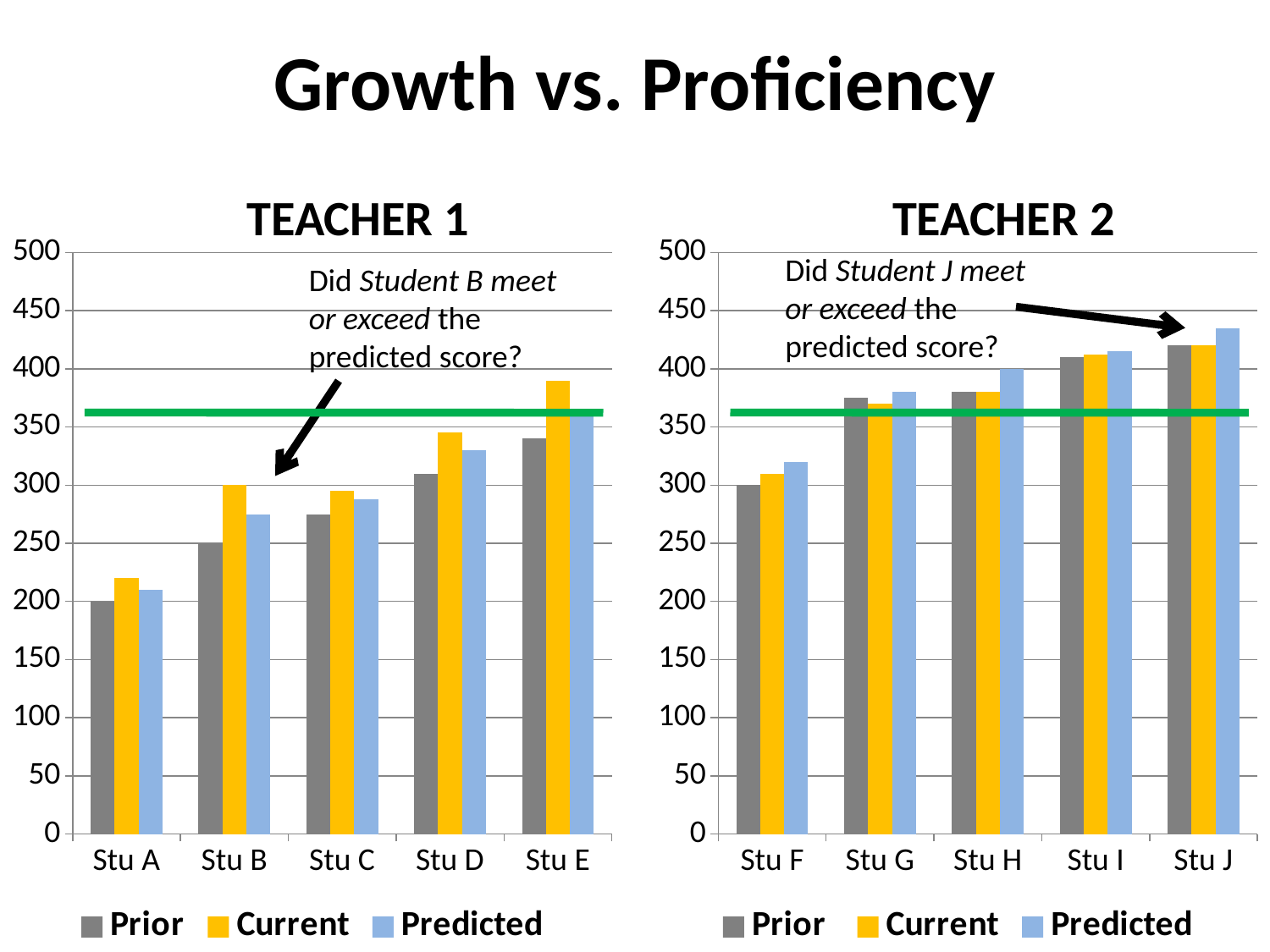
In the TEACHER 1 chart, do the Prior values rise or fall from Stu A to Stu E? rise In the TEACHER 1 chart, what is the Current value for Stu B? 300 How many students are shown on the x axis of the TEACHER 1 chart? 5 What is the title of the chart on the right side of the slide? TEACHER 2 What type of chart is the TEACHER 1 chart? bar chart In the TEACHER 2 chart, which student has the lowest Predicted value? Stu F How many series does the legend of the TEACHER 2 chart list? 3 In the TEACHER 2 chart, is the Predicted value for Stu J greater or less than 400? greater In the TEACHER 1 chart, is the Current value for Stu B larger or smaller than the Predicted value for Stu B? larger In the TEACHER 2 chart, what is the Prior value for Stu F? 300 In the TEACHER 1 chart, which student has the highest Current value? Stu E In the TEACHER 1 chart, what is the Prior value for Stu A? 200